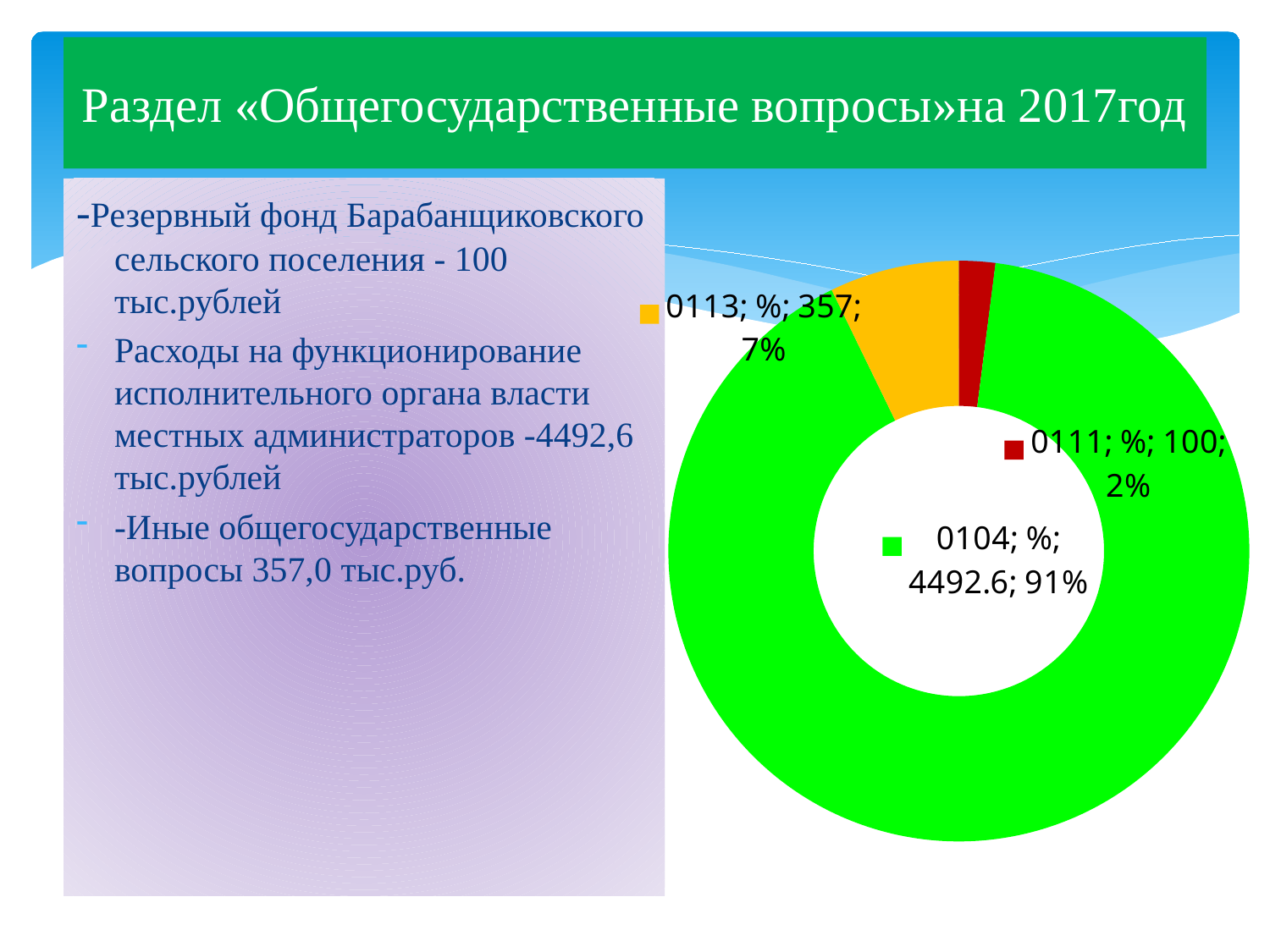
What kind of chart is shown on the slide? doughnut chart What is the value shown for category 0111? 100 What is the difference between the values for 0113 and 0111? 257 Which category has the largest slice? 0104 What share of the chart does category 0111 represent? 2% What share of the chart does category 0113 represent? 7% Which category has the smallest slice? 0111 What is the value shown for category 0104? 4492.6 What share of the chart does category 0104 represent? 91% How many slices does the chart have? 3 What is the value shown for category 0113? 357 Which category has the larger value, 0113 or 0111? 0113